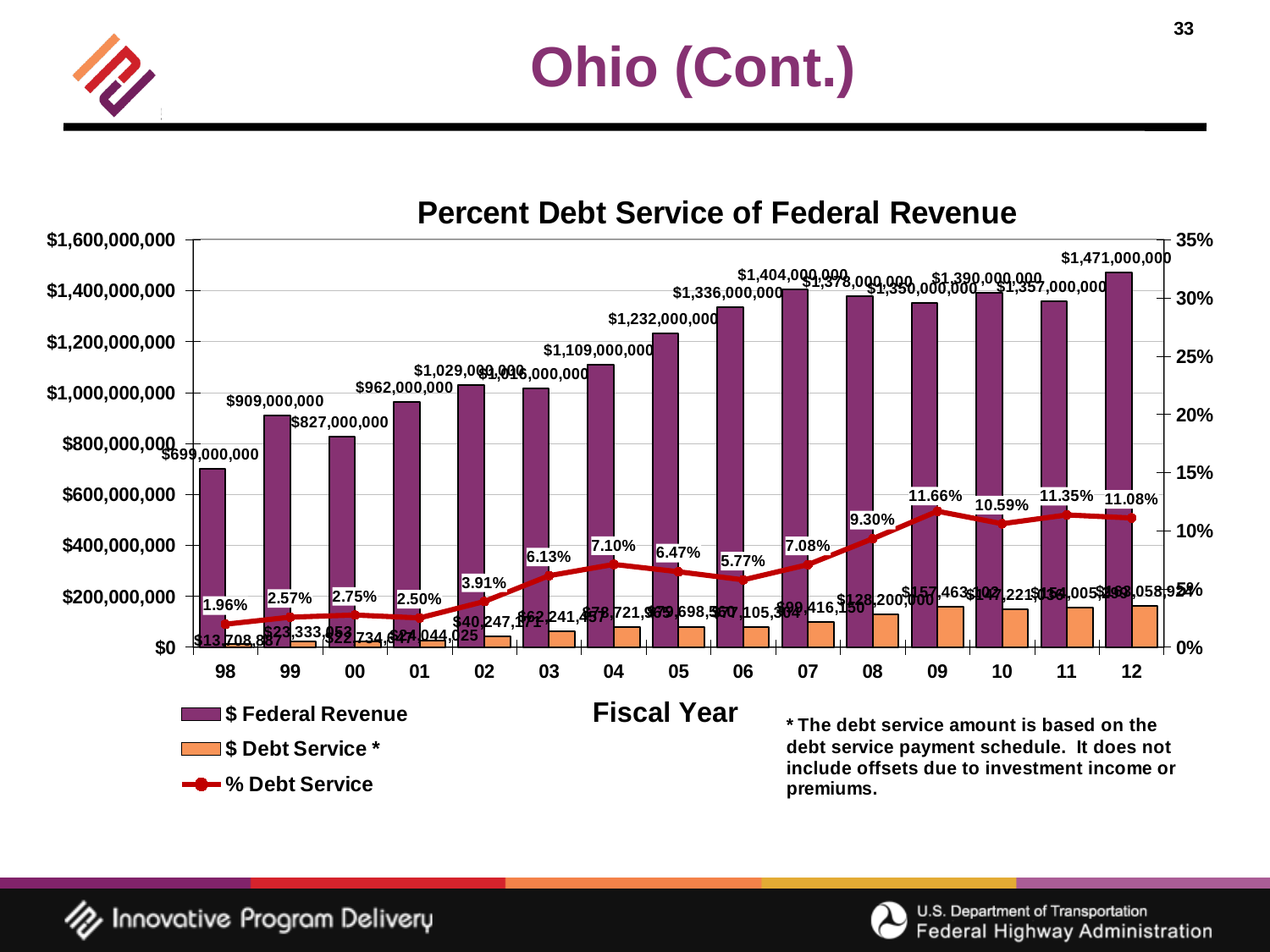
Which fiscal year has the lowest $ Federal Revenue? 98 Which fiscal year has the larger % Debt Service, 10 or 11? 11 What is the $ Federal Revenue value for fiscal year 05? $1,232,000,000 What kind of chart is shown on the slide? A combination bar and line chart What is the % Debt Service value for fiscal year 09? 11.66% Which fiscal year has the highest % Debt Service? 09 What is the title of the x axis? Fiscal Year What is the % Debt Service value for fiscal year 98? 1.96% How many series does the legend list? 3 What is the $ Federal Revenue value for fiscal year 12? $1,471,000,000 What is the difference in $ Federal Revenue between fiscal year 12 and fiscal year 98? $772,000,000 How many fiscal years are shown on the x axis? 15